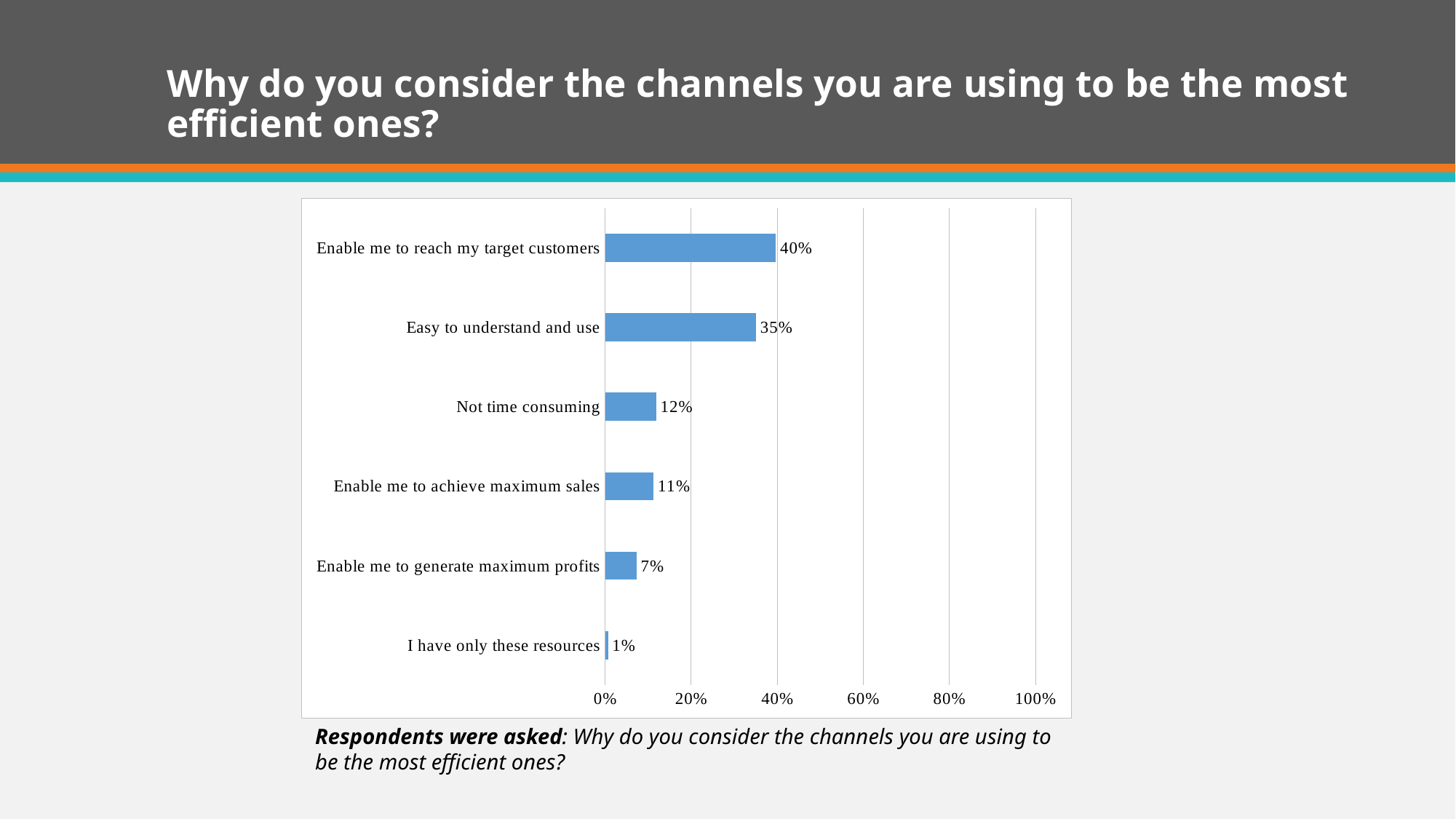
What is the difference between "Not time consuming" and "Enable me to generate maximum profits"? 5% Is the value for "Easy to understand and use" greater or less than 40%? less What kind of chart is shown on the slide? Bar chart Which is larger: "Enable me to achieve maximum sales" or "Enable me to generate maximum profits"? Enable me to achieve maximum sales What is the value for "Enable me to generate maximum profits"? 7% What is the value for "Easy to understand and use"? 35% Which reason has the lowest percentage? I have only these resources What is the difference between "Enable me to reach my target customers" and "Easy to understand and use"? 5% Which reason has the highest percentage? Enable me to reach my target customers What percentage of respondents said the channels enable them to reach their target customers? 40% What is the value for "Not time consuming"? 12% How many reasons (categories) are shown in the chart? 6